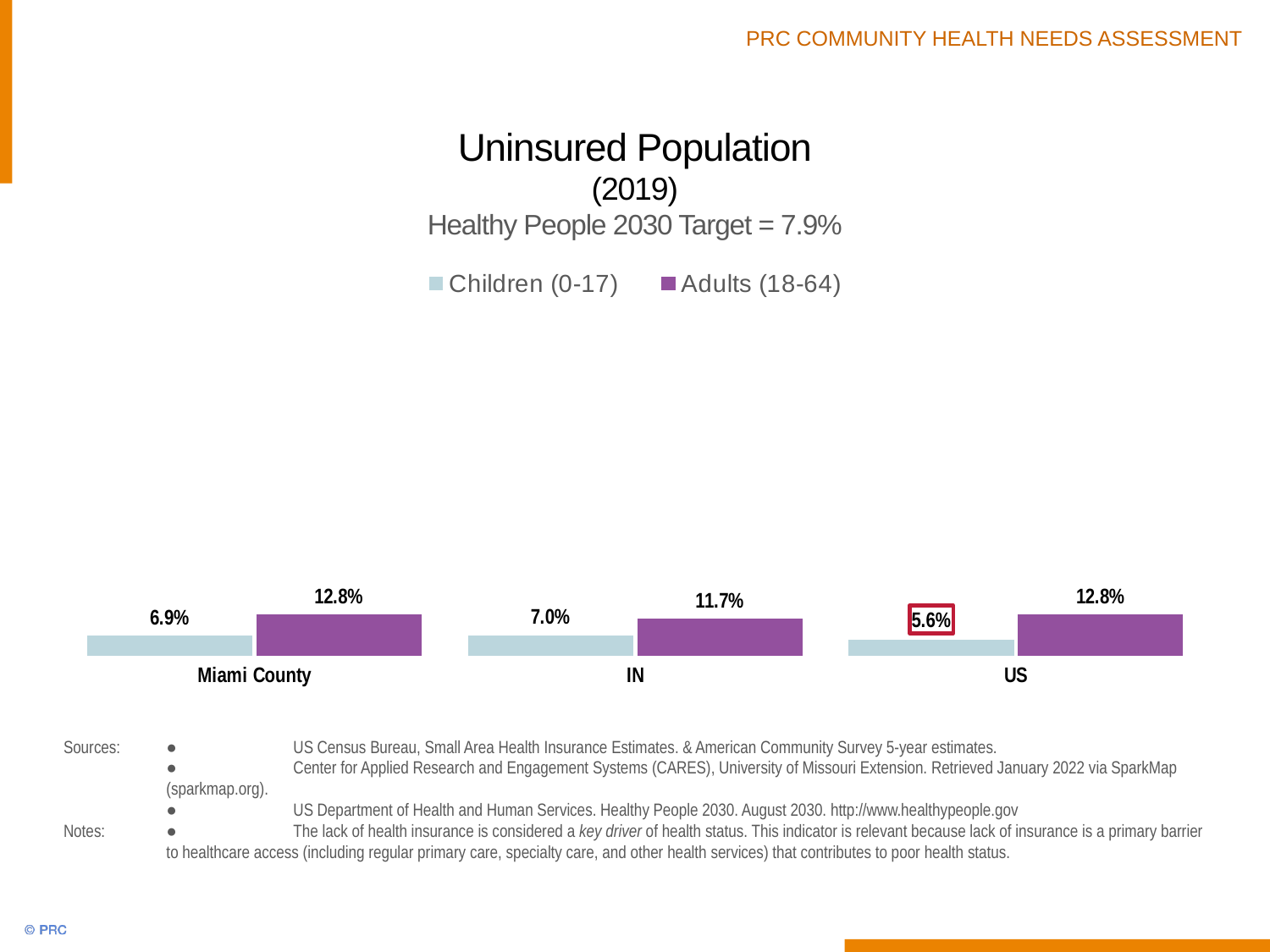
Which area has the lowest uninsured rate for Children (0-17)? US What is the uninsured rate for Adults (18-64) in Miami County? 12.8% What is the Healthy People 2030 Target shown in the chart title? 7.9% Which is larger, the Children (0-17) uninsured rate in IN or in Miami County? IN What is the uninsured rate for Children (0-17) in the US? 5.6% How many areas are shown on the chart? 3 How many series does the legend list? 2 What is the difference between the Children (0-17) uninsured rates in Miami County and the US? 1.3% What is the uninsured rate for Adults (18-64) in IN? 11.7% What is the difference between the Adults (18-64) and Children (0-17) uninsured rates in IN? 4.7% Which area has the lowest uninsured rate for Adults (18-64)? IN What is the uninsured rate for Children (0-17) in Miami County? 6.9%